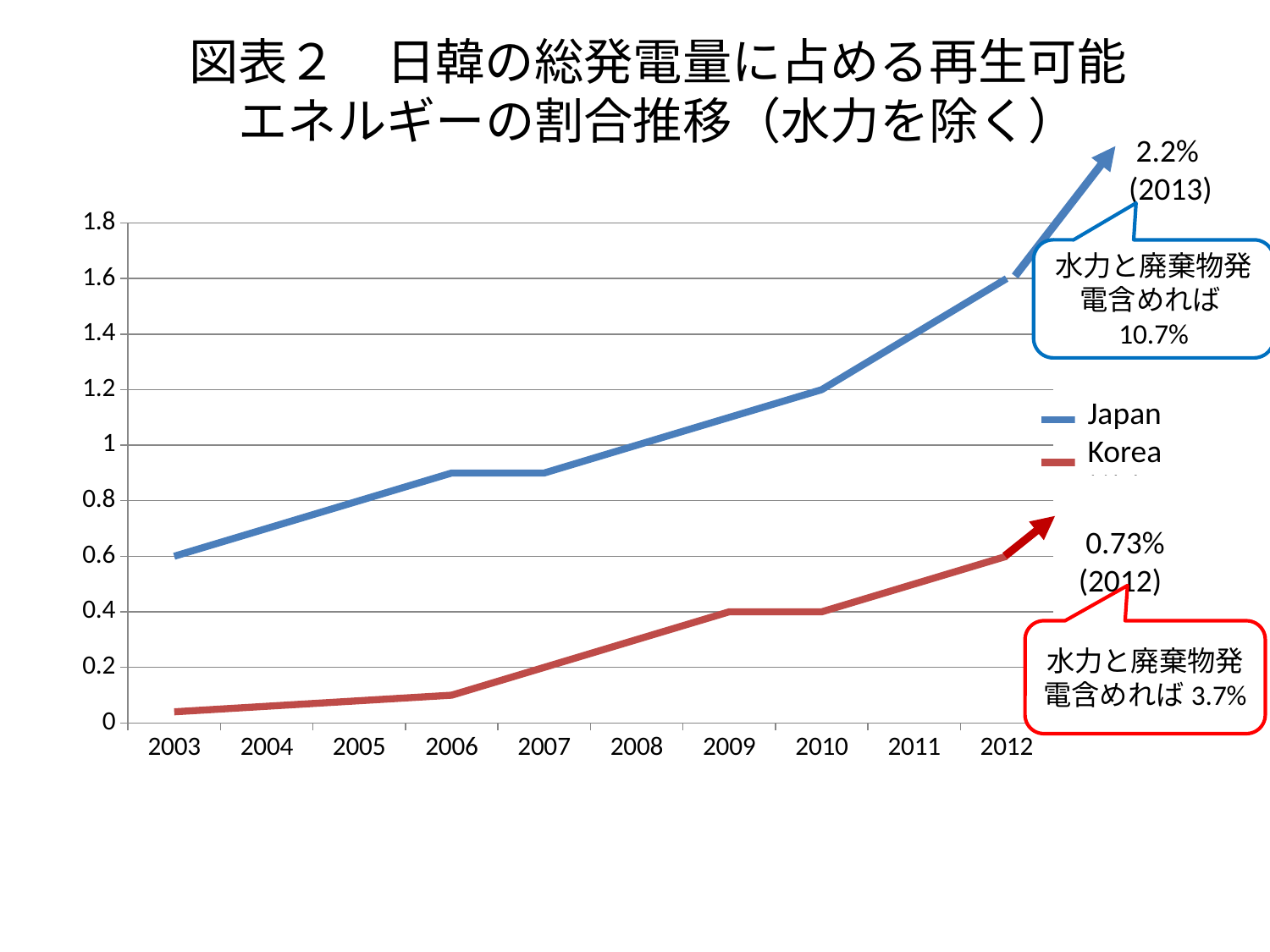
Which series has the higher value in 2010, Japan or Korea? Japan In which year does the Japan series reach its highest value? 2012 How many years are shown on the x axis? 10 What is the value for Japan in 2003? 0.6 How many series does the legend list? 2 Do the values for Korea generally rise or fall from 2003 to 2012? rise What is the value for Japan in 2012? 1.6 What is the value for Korea in 2012? 0.6 Is the value for Korea in 2006 greater or less than 0.2? less What kind of chart is shown on the slide? line chart What is the difference between the Japan and Korea values in 2012? 1 Is the value for Japan in 2006 greater or less than 0.8? greater